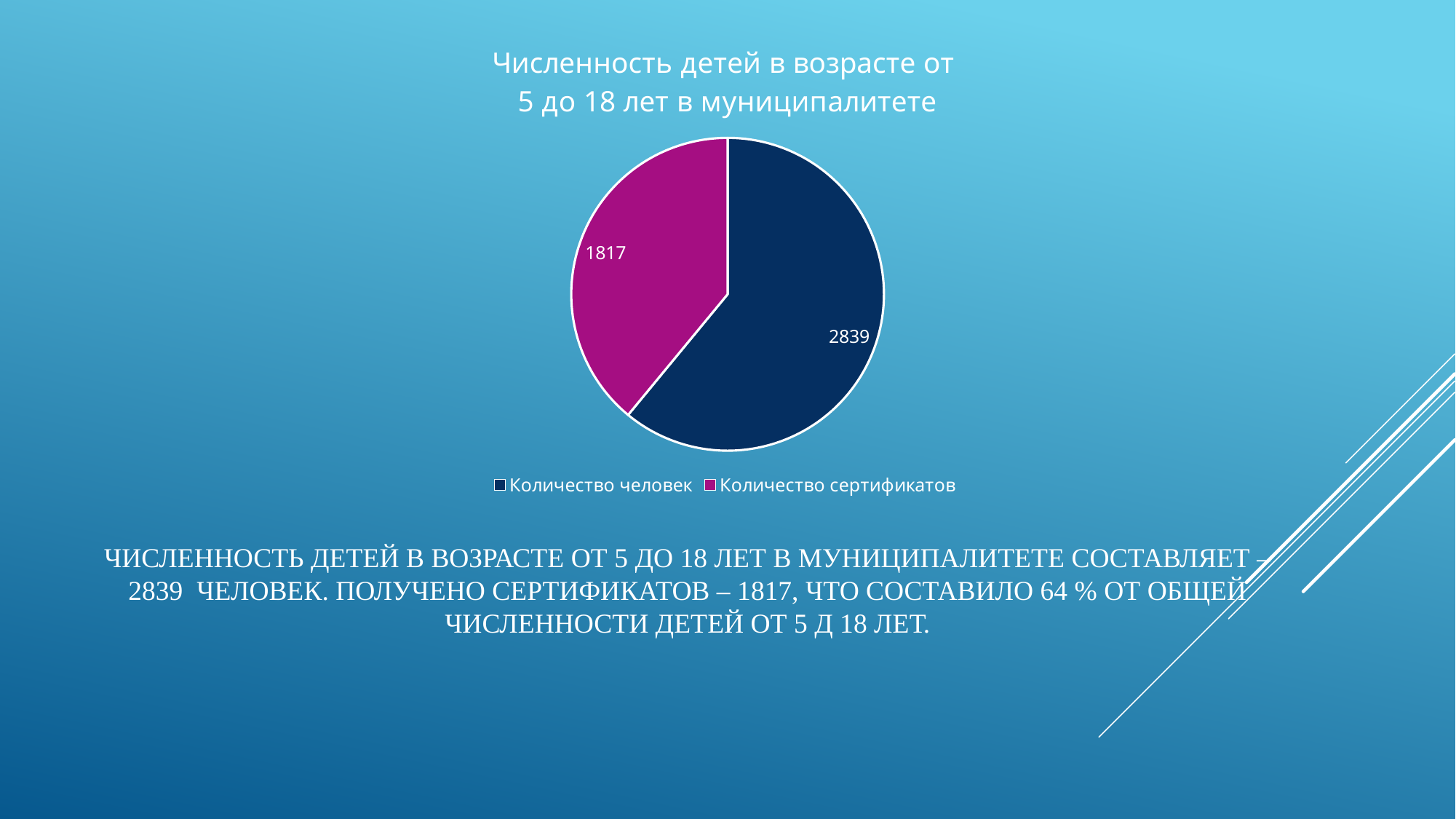
What is the title of the pie chart? Численность детей в возрасте от 5 до 18 лет в муниципалитете What is the sum of the two values shown in the pie chart? 4656 Which category has the largest slice in the pie chart? Количество человек Which category has the smallest slice in the pie chart? Количество сертификатов Which is larger: "Количество человек" or "Количество сертификатов"? Количество человек What colour is the slice for "Количество сертификатов" in the pie chart? magenta What is the value for "Количество человек" in the pie chart? 2839 What is the value for "Количество сертификатов" in the pie chart? 1817 What type of chart is shown on the slide? pie chart How many slices does the pie chart have? 2 How many entries does the legend of the pie chart list? 2 What is the difference between the values for "Количество человек" and "Количество сертификатов"? 1022